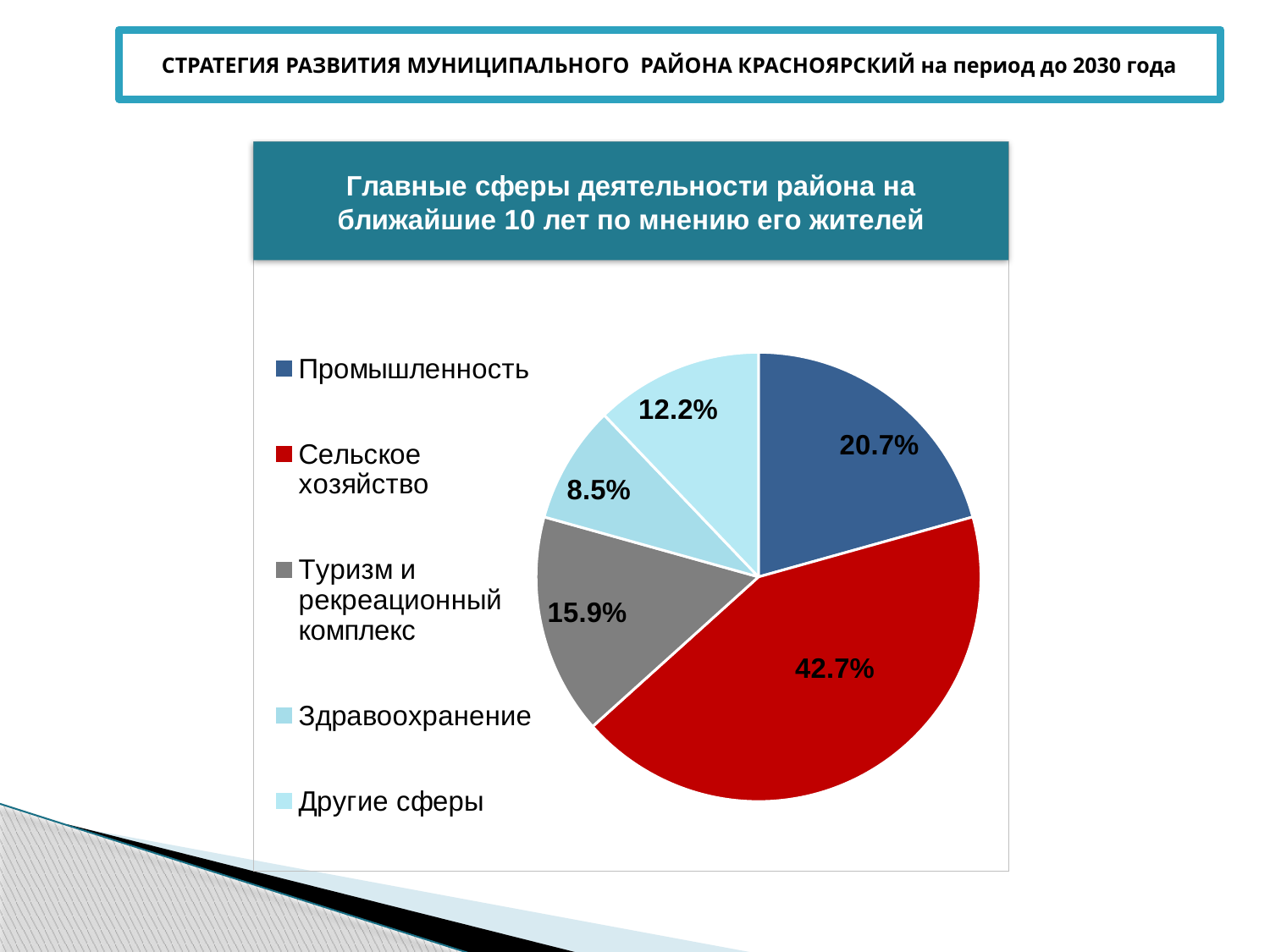
What share of the pie does Туризм и рекреационный комплекс have? 15.9% What is the title of the chart? Главные сферы деятельности района на ближайшие 10 лет по мнению его жителей What is the difference in percentage points between Сельское хозяйство and Промышленность? 22.0 Which is larger, the slice for Туризм и рекреационный комплекс or the slice for Другие сферы? Туризм и рекреационный комплекс How many categories does the pie chart show? 5 Which category has the largest slice of the pie? Сельское хозяйство What type of chart is shown on the slide? Pie chart What share of the pie does Другие сферы have? 12.2% What share of the pie does Промышленность have? 20.7% What share of the pie does Сельское хозяйство have? 42.7% Which category has the smallest slice of the pie? Здравоохранение What share of the pie does Здравоохранение have? 8.5%